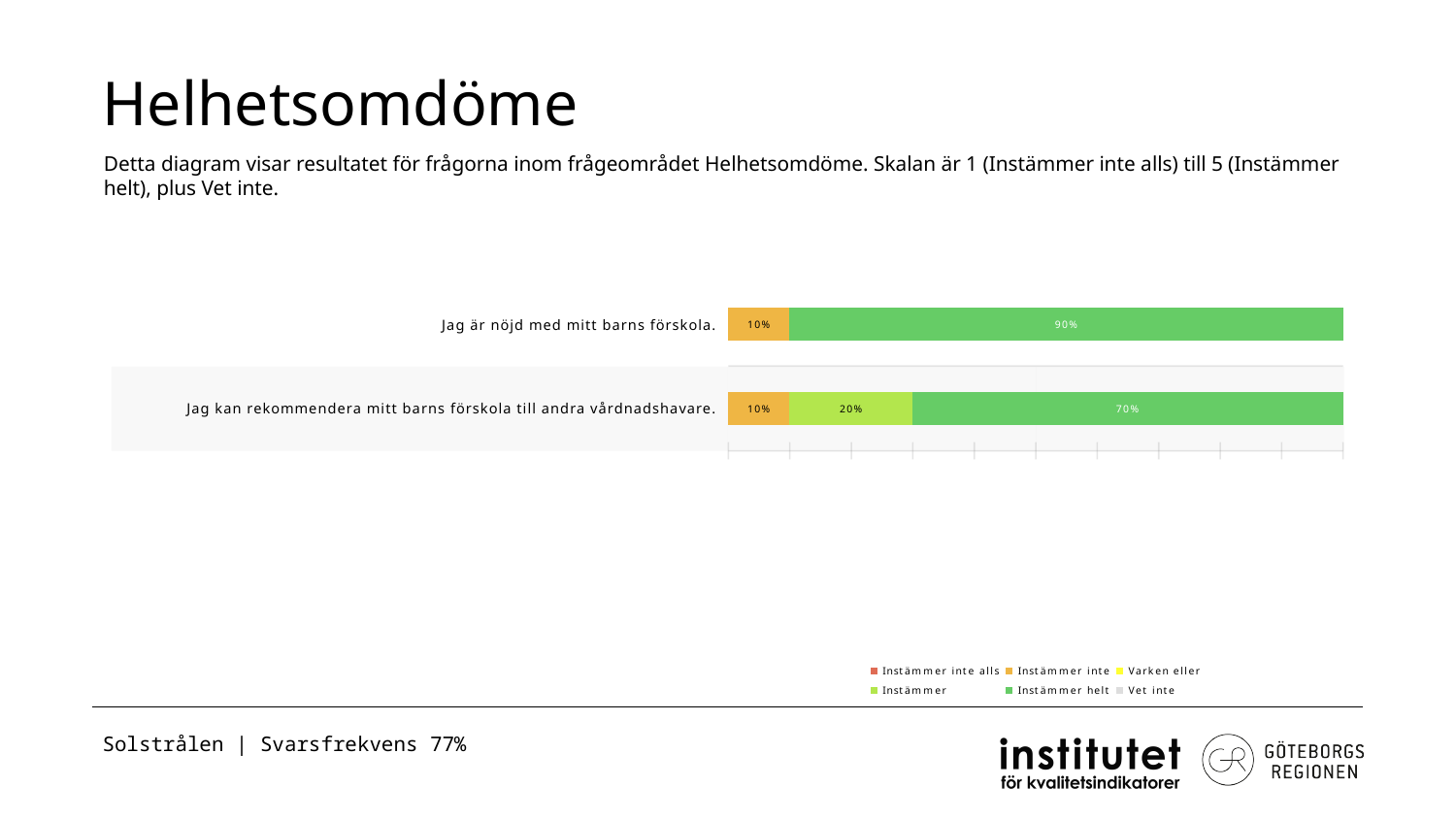
What kind of chart is shown on the slide? stacked bar chart Which category has the higher "Instämmer helt" value? Jag är nöjd med mitt barns förskola. What is the difference between the "Instämmer helt" values of the two categories? 20% What is the "Instämmer inte" value for "Jag är nöjd med mitt barns förskola."? 10% How many categories (questions) are plotted in the chart? 2 Which legend entry is shown in grey? Vet inte What is the "Instämmer helt" value for "Jag är nöjd med mitt barns förskola."? 90% What is the "Instämmer" value for "Jag kan rekommendera mitt barns förskola till andra vårdnadshavare."? 20% What is the "Instämmer helt" value for "Jag kan rekommendera mitt barns förskola till andra vårdnadshavare."? 70% Is the "Instämmer helt" value for "Jag är nöjd med mitt barns förskola." larger or smaller than the "Instämmer helt" value for "Jag kan rekommendera mitt barns förskola till andra vårdnadshavare."? larger How many series does the legend list? 6 What is the total of the stacked bar for "Jag kan rekommendera mitt barns förskola till andra vårdnadshavare."? 100%